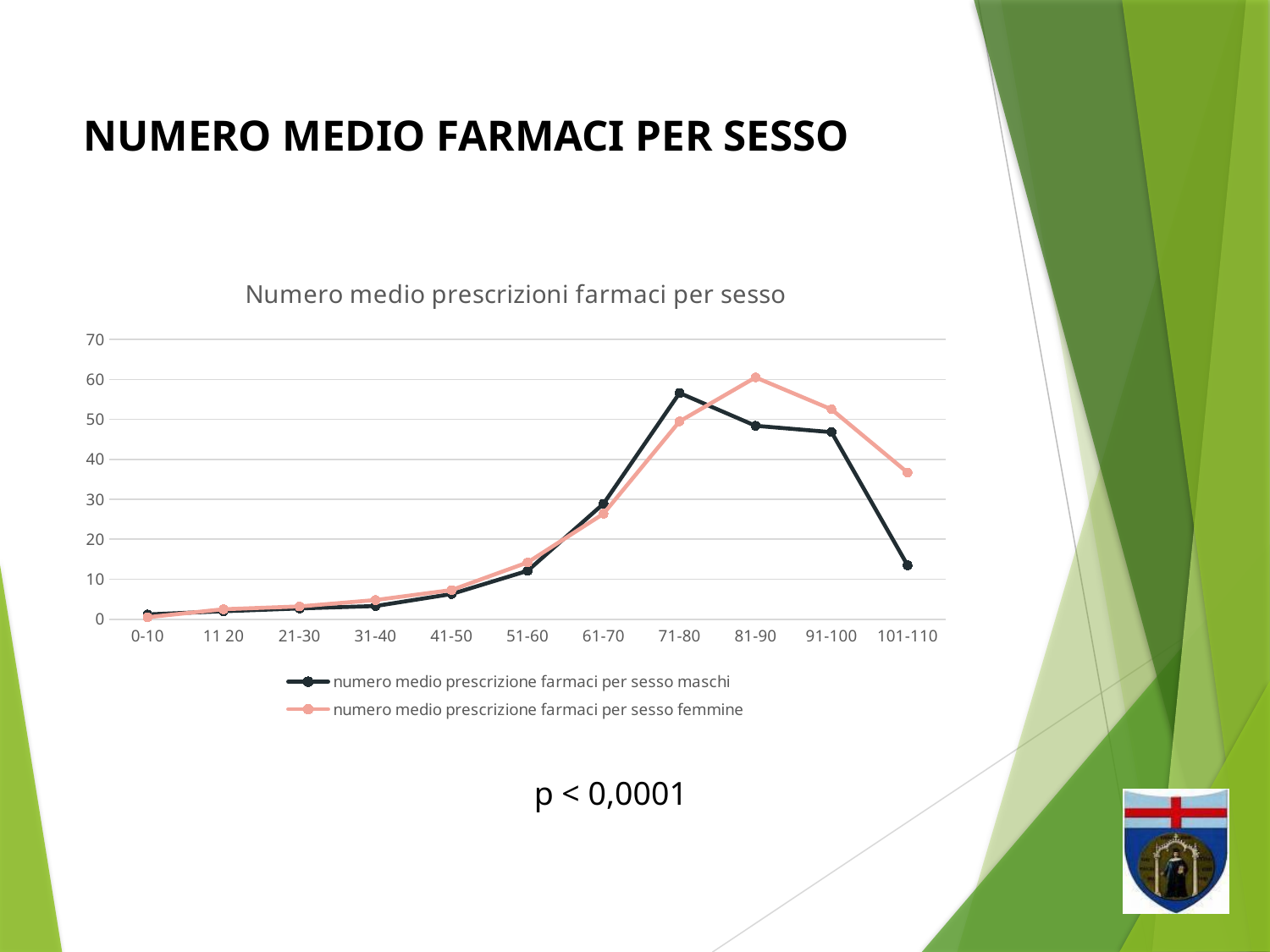
How many age categories are shown on the x axis? 11 What is the title of the chart? Numero medio prescrizioni farmaci per sesso At 71-80, which series has the larger value, 'maschi' or 'femmine'? maschi In which age category does the 'femmine' series reach its highest value? 81-90 In which age category does the 'maschi' series reach its highest value? 71-80 Is the value for 'femmine' at 101-110 greater or less than 30? greater Is the value for 'maschi' at 101-110 greater or less than 20? less At 101-110, which series has the larger value, 'maschi' or 'femmine'? femmine Does the 'femmine' series rise or fall from 81-90 to 101-110? fall How many series does the legend list? 2 Is the value for 'femmine' at 81-90 greater or less than 50? greater What kind of chart is shown on the slide? Line chart